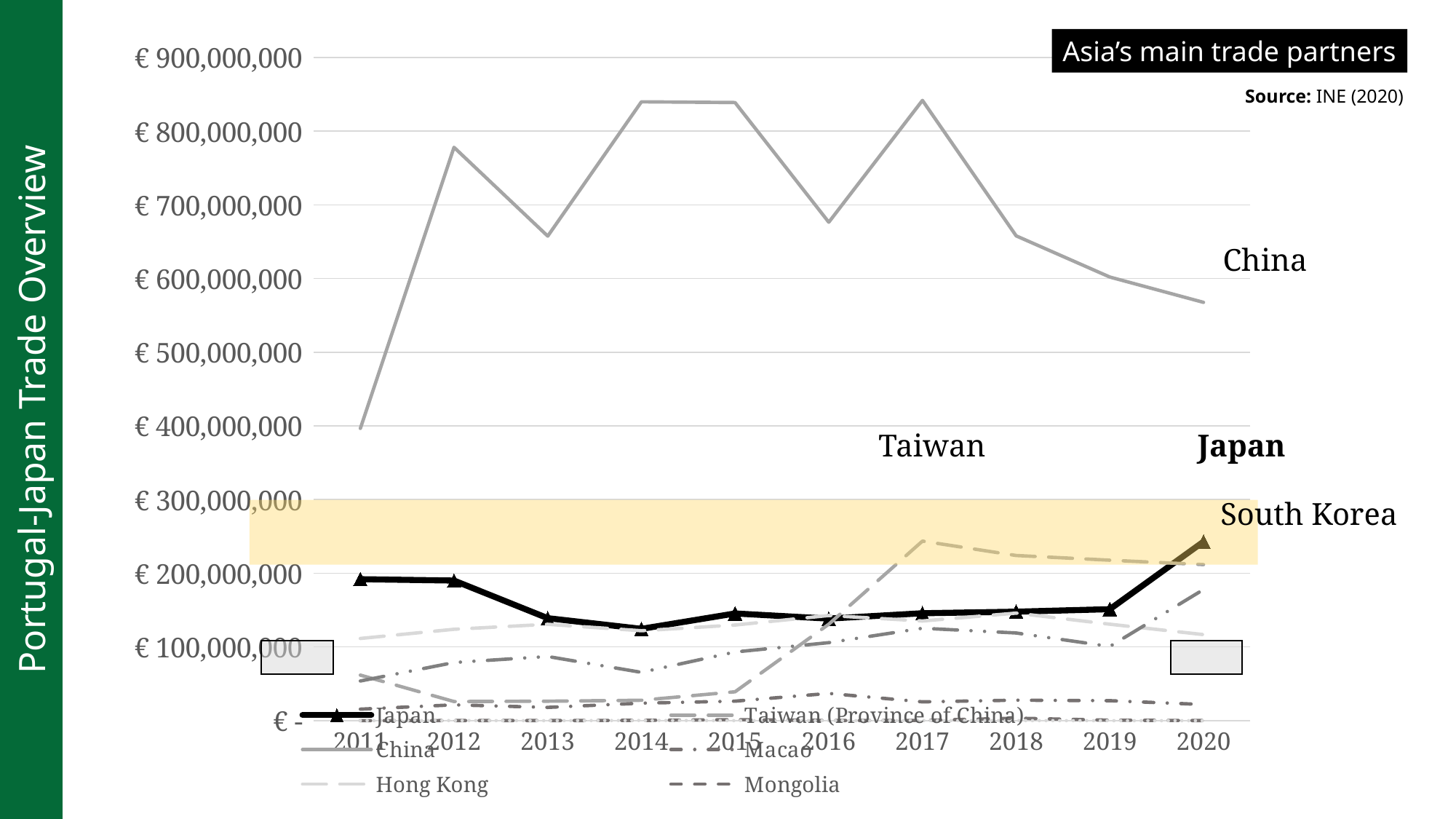
Does the China series rise or fall from 2017 to 2020? Fall In which year does the Japan series reach its highest value? 2020 Which is larger in 2020, the value for China or the value for Japan? China What is the source cited for the chart? INE (2020) Is the value for China in 2020 greater or less than € 600,000,000? less How many series does the legend list? 6 Is the value for China in 2012 greater or less than € 700,000,000? greater Is the value for China in 2014 greater or less than € 800,000,000? greater How many years are shown on the x axis? 10 Which series has the highest values across the whole period? China What kind of chart is shown on the slide? Line chart